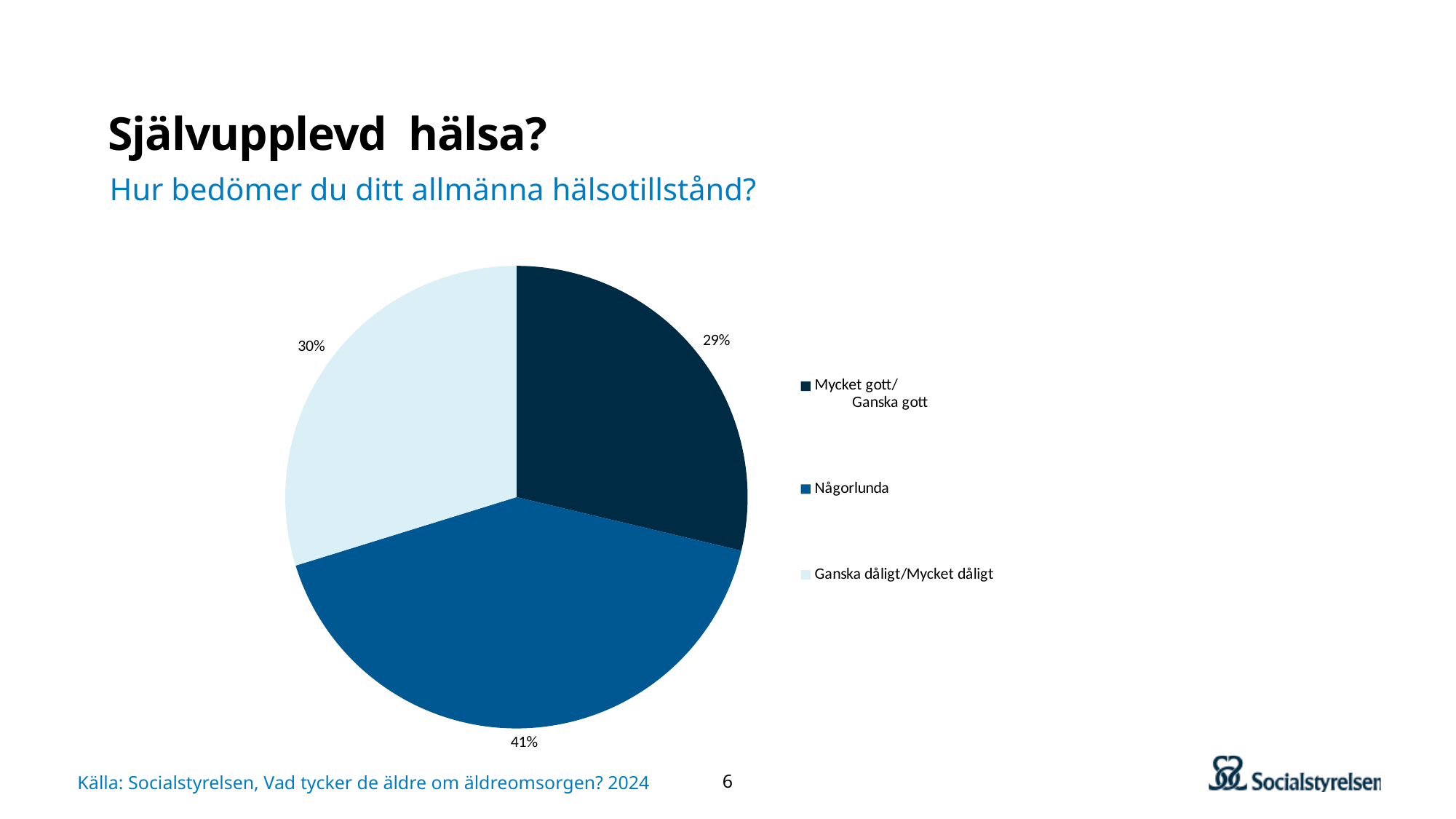
What kind of chart is shown on the slide? pie chart What is the difference in percentage points between the "Någorlunda" slice and the "Mycket gott/Ganska gott" slice? 12 What share of the pie is labelled "Ganska dåligt/Mycket dåligt"? 30% Which category has the smallest slice of the pie? Mycket gott/Ganska gott How many slices does the pie chart have? 3 What question does the chart's subtitle ask? Hur bedömer du ditt allmänna hälsotillstånd? What share of the pie is labelled "Någorlunda"? 41% What share of the pie is labelled "Mycket gott/Ganska gott"? 29% Which category has the largest slice of the pie? Någorlunda Which legend entry is shown in the lightest colour? Ganska dåligt/Mycket dåligt How many entries does the legend list? 3 Which is larger, the "Ganska dåligt/Mycket dåligt" slice or the "Mycket gott/Ganska gott" slice? Ganska dåligt/Mycket dåligt